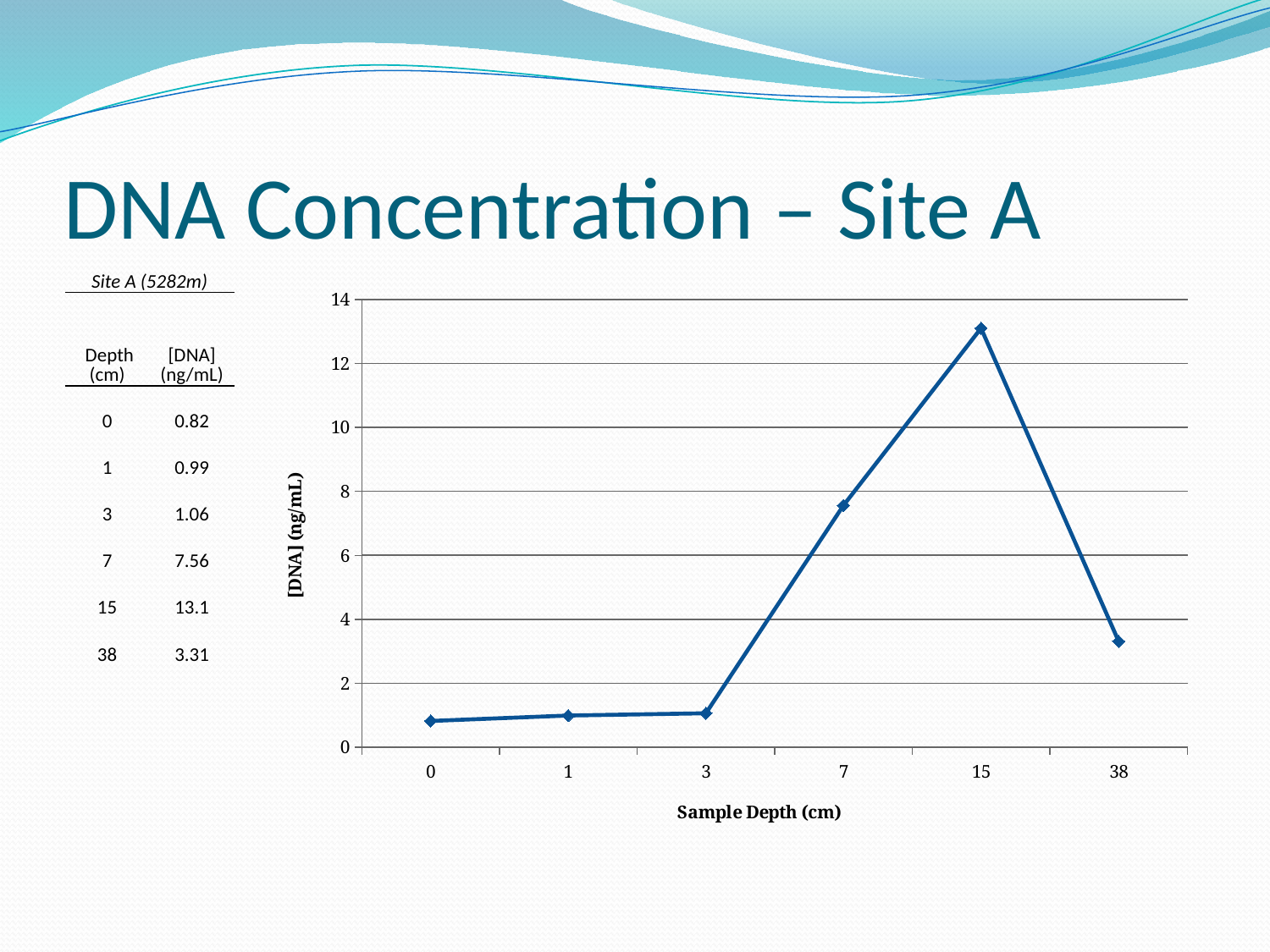
What is the difference between the DNA concentration at 15 cm and at 7 cm? 5.54 What is the DNA concentration at a sample depth of 38 cm? 3.31 At which sample depth is the DNA concentration lowest? 0 At which sample depth is the DNA concentration highest? 15 Does the DNA concentration rise or fall between depths of 15 cm and 38 cm? fall Is the DNA concentration at a depth of 7 cm greater or less than 6? greater What is the label of the x axis of the chart? Sample Depth (cm) What kind of chart is shown on the slide? line chart Which has a higher DNA concentration, a depth of 7 cm or a depth of 38 cm? 7 What is the DNA concentration at a sample depth of 15 cm? 13.1 What is the DNA concentration at a sample depth of 0 cm? 0.82 How many sample depths are plotted on the chart? 6